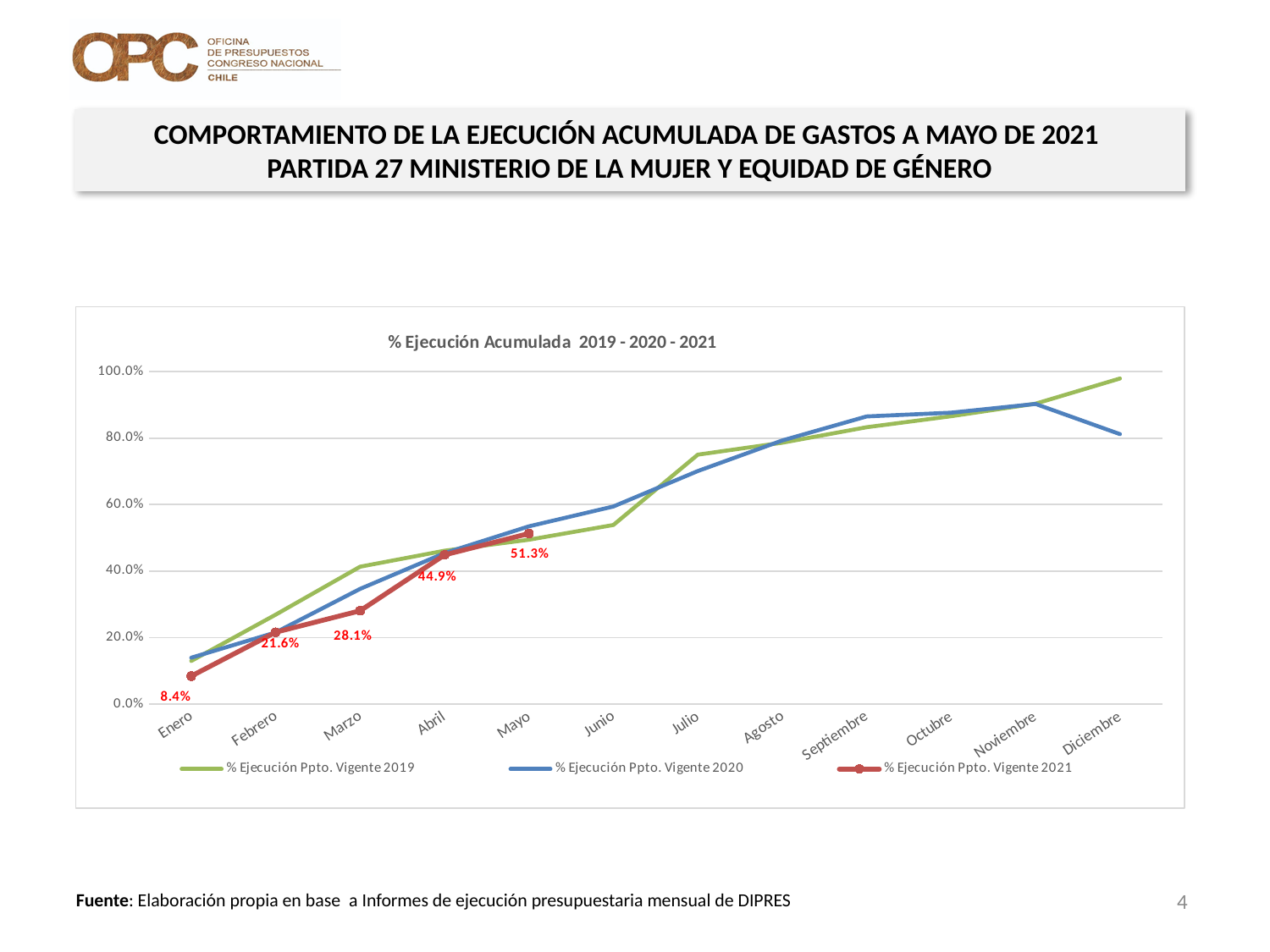
What is the difference between the Febrero and Enero values of % Ejecución Ppto. Vigente 2021? 13.2% How many months are shown along the x axis of the chart? 12 What is the value of % Ejecución Ppto. Vigente 2021 for Enero? 8.4% By how much does % Ejecución Ppto. Vigente 2021 increase from Abril to Mayo? 6.4% Is the value of % Ejecución Ppto. Vigente 2019 for Diciembre greater or less than 80.0%? greater What kind of chart is shown on the slide? Line chart What is the value of % Ejecución Ppto. Vigente 2021 for Marzo? 28.1% In Diciembre, which series is higher: % Ejecución Ppto. Vigente 2019 or % Ejecución Ppto. Vigente 2020? % Ejecución Ppto. Vigente 2019 Does the % Ejecución Ppto. Vigente 2021 series rise or fall from Enero to Mayo? Rise Which month has the highest value for % Ejecución Ppto. Vigente 2021? Mayo What is the value of % Ejecución Ppto. Vigente 2021 for Mayo? 51.3% How many series does the chart legend list? 3